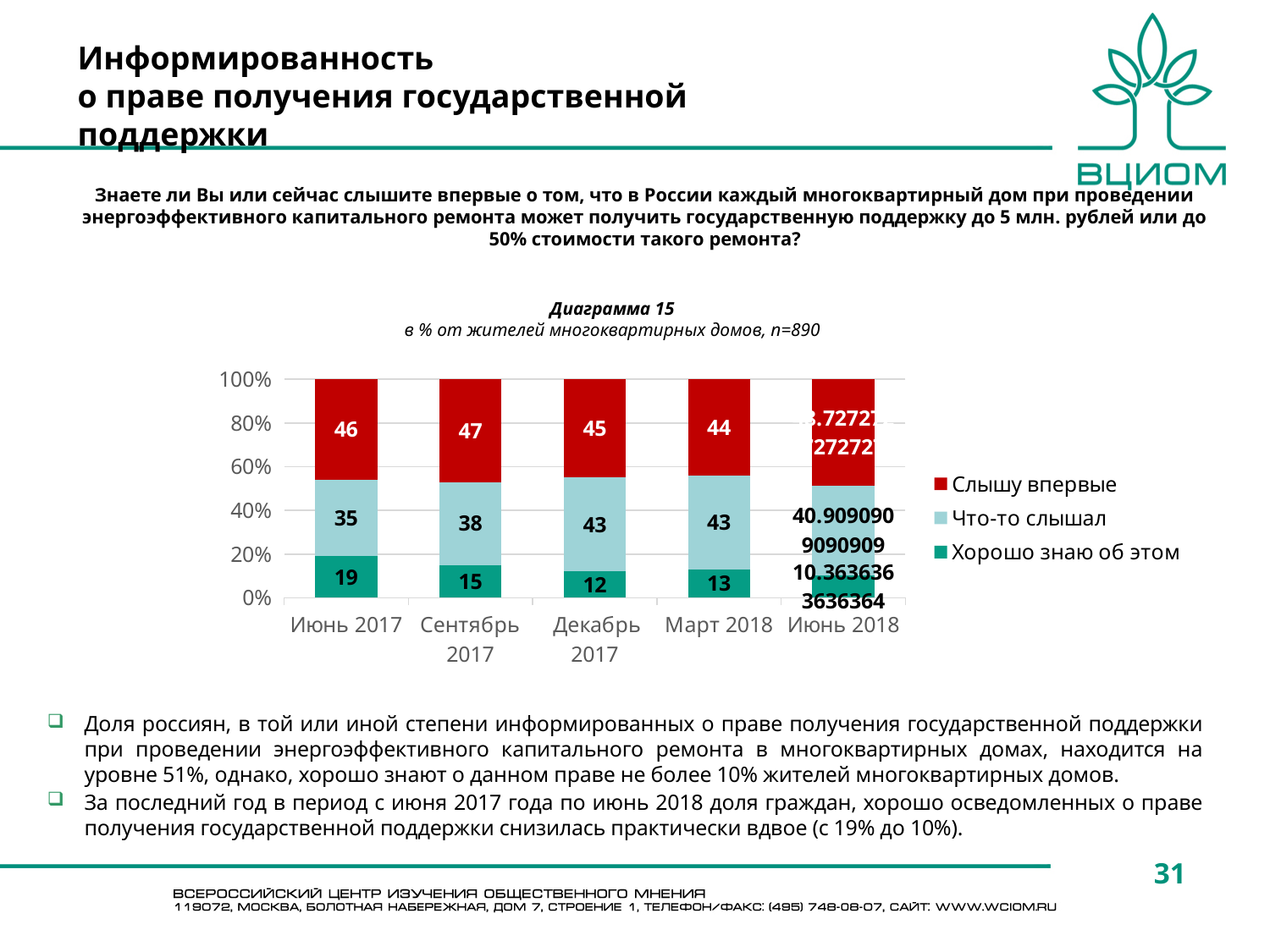
How many series does the legend list? 3 What kind of chart is shown on the slide? Stacked bar chart How many periods are shown on the x axis? 5 Which is larger: "Что-то слышал" in Сентябрь 2017 or "Что-то слышал" in Март 2018? Март 2018 In which period is the "Что-то слышал" value the lowest? Июнь 2017 What is the difference between the "Слышу впервые" values for Сентябрь 2017 and Март 2018? 3 What is the value for "Хорошо знаю об этом" in Июнь 2017? 19 What is the value for "Что-то слышал" in Декабрь 2017? 43 Which series is shown in red in the chart? Слышу впервые What is the value for "Хорошо знаю об этом" in Март 2018? 13 In which period is the "Хорошо знаю об этом" value the highest? Июнь 2017 What is the value for "Слышу впервые" in Сентябрь 2017? 47